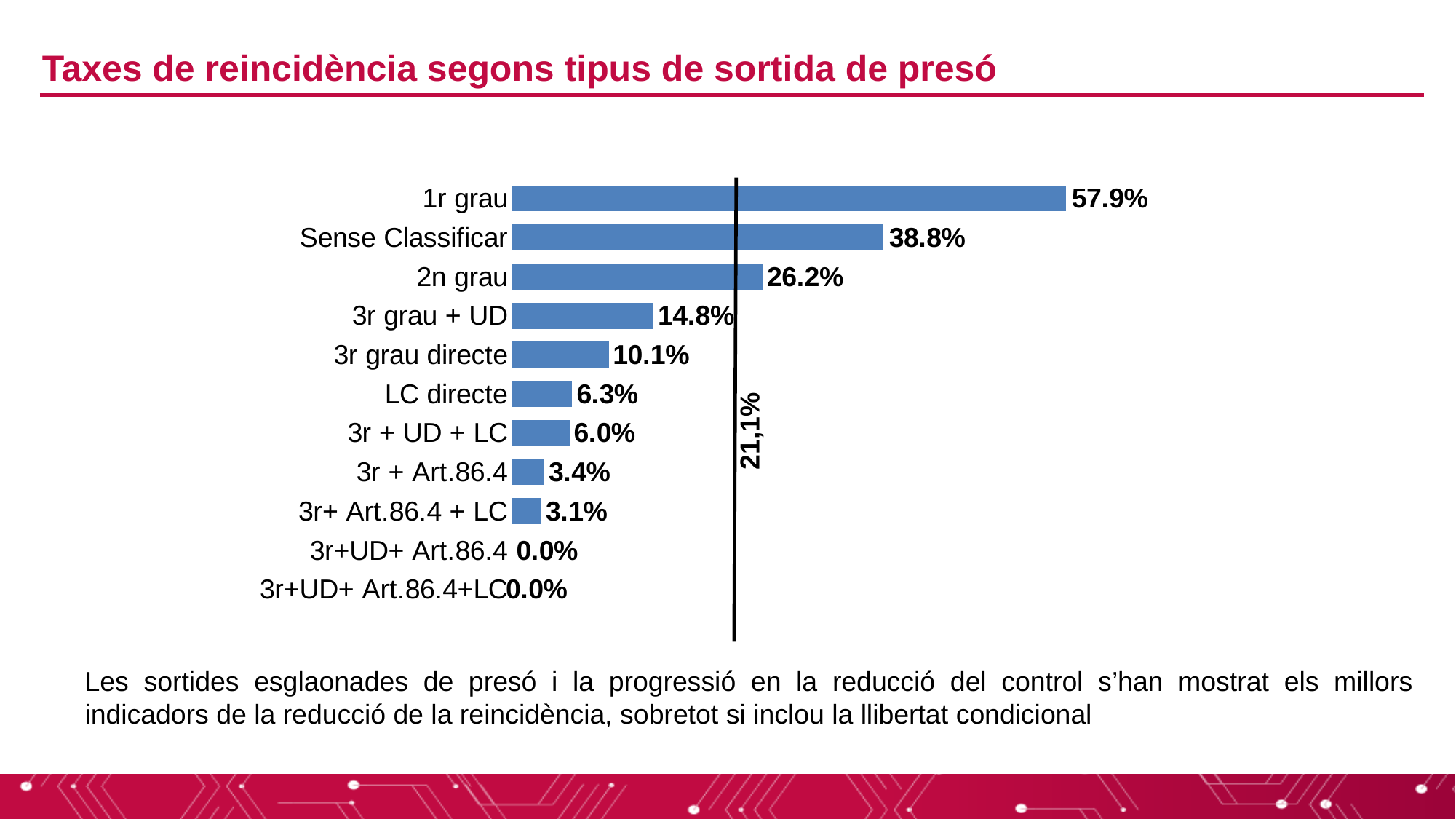
Which category has the highest recidivism rate? 1r grau How many categories have a value of 0.0%? 2 What is the value shown for 'Sense Classificar'? 38.8% What kind of chart is shown on the slide? Bar chart What value is marked by the vertical black reference line on the chart? 21,1% What is the value shown for '3r + Art.86.4'? 3.4% How many categories are shown in the chart? 11 What is the recidivism rate for '1r grau'? 57.9% What is the difference between the values for '2n grau' and '3r grau + UD'? 11.4% Which is larger, the value for 'LC directe' or the value for '3r + UD + LC'? LC directe What is the value shown for '3r grau directe'? 10.1% What is the difference between the values for '1r grau' and 'Sense Classificar'? 19.1%